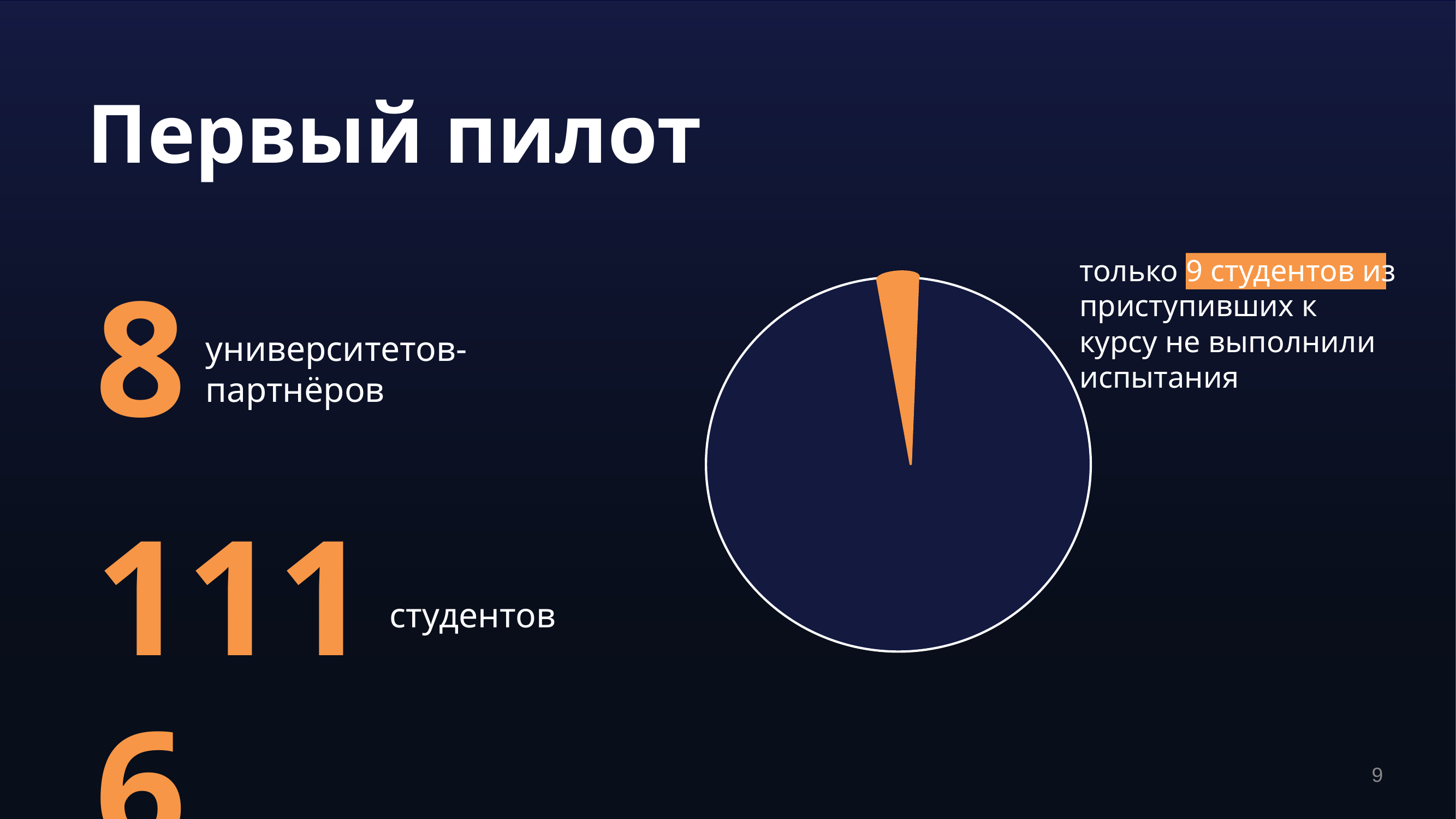
Which slice of the pie chart is larger, the orange one or the dark blue one? the dark blue one What colour is the small slice of the pie chart? orange Which slice of the pie chart is the smallest? the orange slice Does the pie chart have a legend? No Is the orange slice's share of the pie greater or less than 50%? less What kind of chart is shown on the slide? pie chart How many slices does the pie chart have? 2